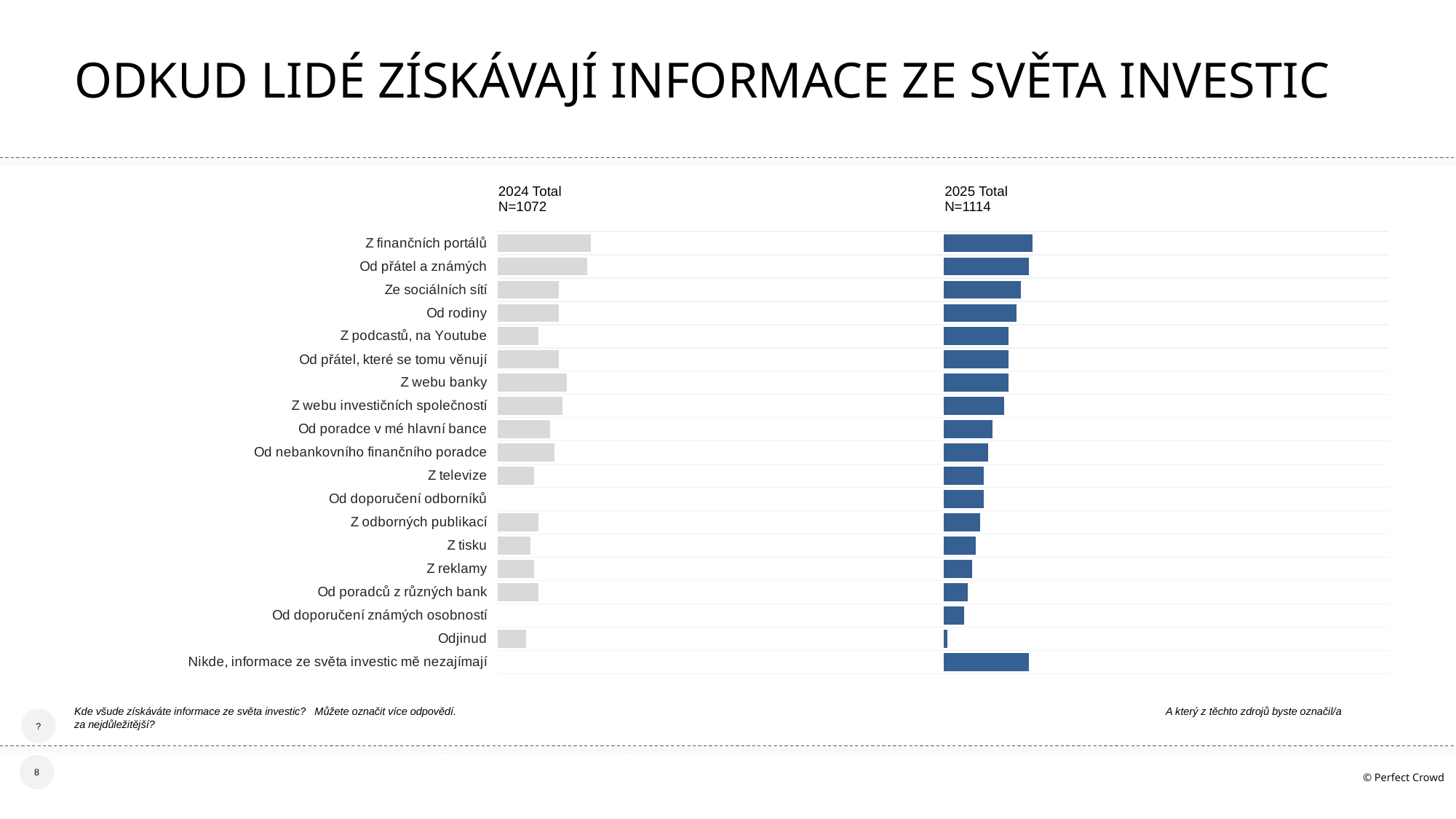
In the 2025 Total chart, which is larger: Od rodiny or Od poradců z různých bank? Od rodiny In the 2025 Total chart, which is larger: Z finančních portálů or Z tisku? Z finančních portálů In the 2025 Total chart, which category has the shortest bar? Odjinud In the 2024 Total chart, which is larger: Z webu banky or Z televize? Z webu banky What is the sample size (N) shown for the 2024 Total chart? N=1072 What kind of chart is used on this slide to show the sources of investment information? Bar chart What is the sample size (N) shown for the 2025 Total chart? N=1114 How many information-source categories are listed on the slide? 19